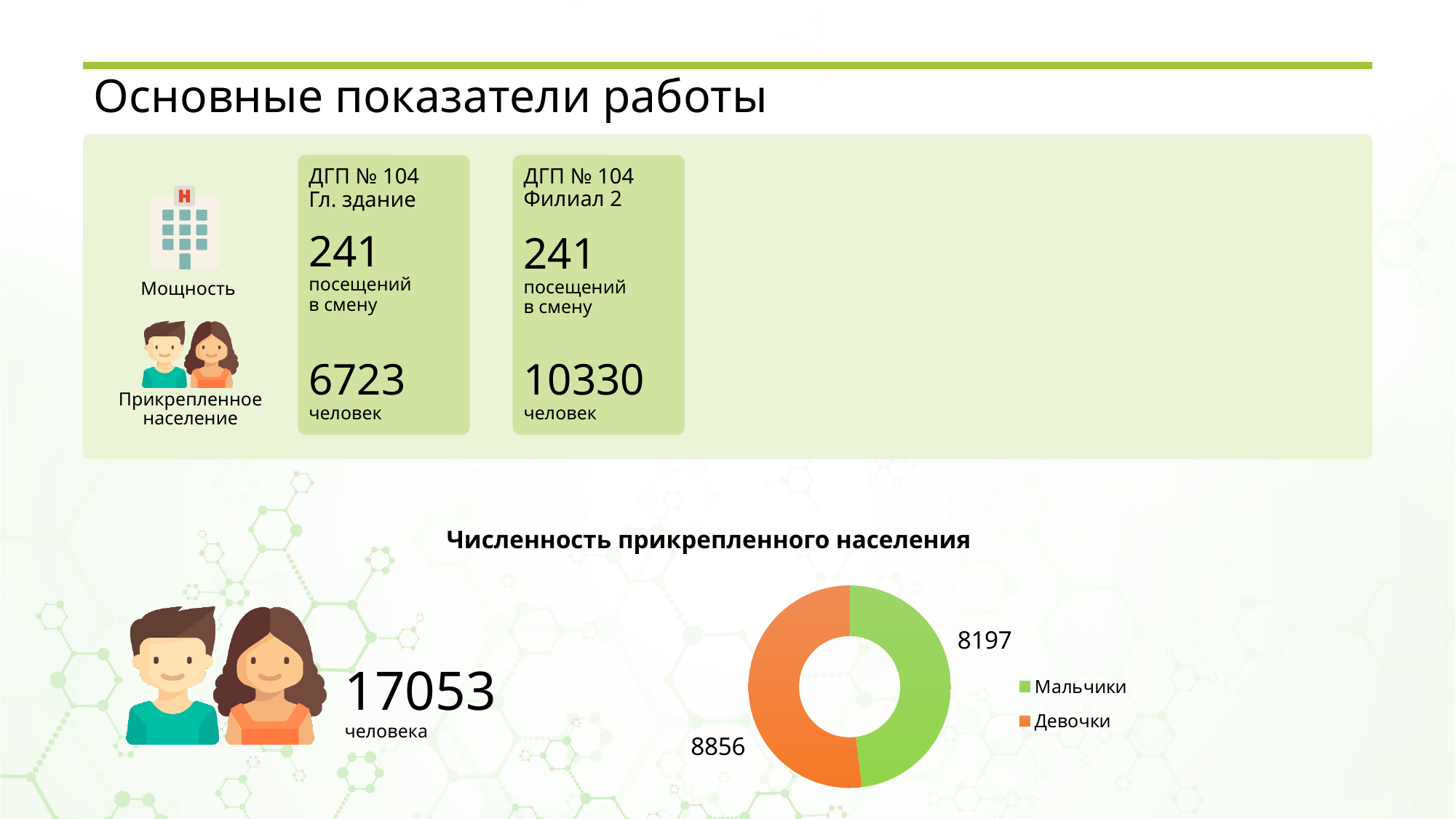
What colour is the Девочки slice in the chart 'Численность прикрепленного населения'? Orange How many categories are shown in the chart 'Численность прикрепленного населения'? 2 In the chart 'Численность прикрепленного населения', what is the difference between the values for Девочки and Мальчики? 659 How many entries does the legend of the chart 'Численность прикрепленного населения' list? 2 What is the value for Девочки in the chart 'Численность прикрепленного населения'? 8856 What is the total of the two slices in the chart 'Численность прикрепленного населения'? 17053 What is the title of the doughnut chart on the slide? Численность прикрепленного населения What is the value for Мальчики in the chart 'Численность прикрепленного населения'? 8197 Which category has the largest slice in the chart 'Численность прикрепленного населения'? Девочки In the chart 'Численность прикрепленного населения', which is larger: Мальчики or Девочки? Девочки What type of chart is 'Численность прикрепленного населения'? Doughnut chart Which category has the smallest slice in the chart 'Численность прикрепленного населения'? Мальчики